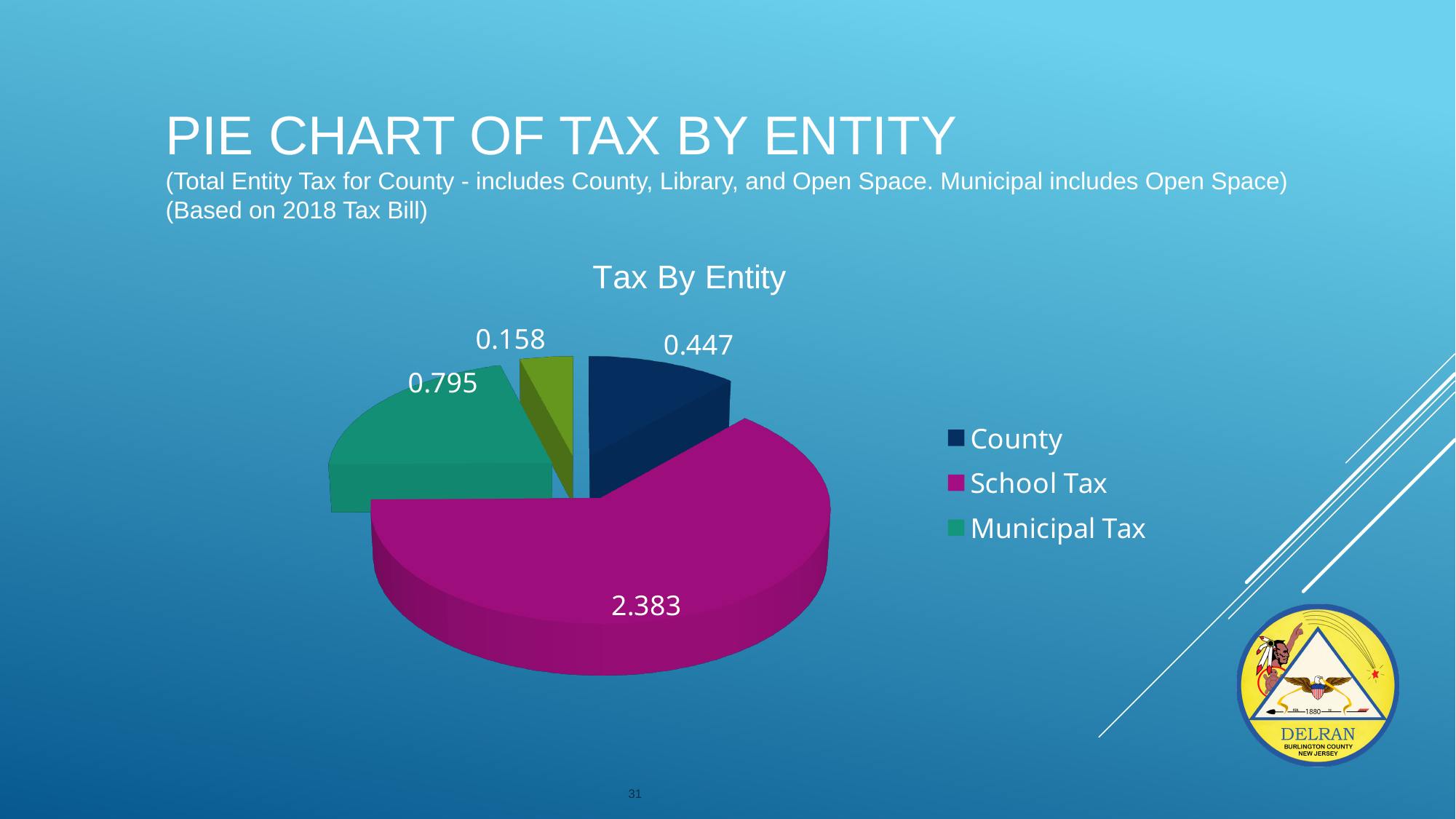
Which entity has the largest slice of the pie? School Tax What is the value for County? 0.447 What is the difference between the Municipal Tax value and the County value? 0.348 What type of chart is shown on the slide? Pie chart What is the value for Municipal Tax? 0.795 What is the value for School Tax? 2.383 Which is larger, the Municipal Tax value or the County value? Municipal Tax How many slices does the pie chart have? 4 What is the smallest value labelled on the pie chart? 0.158 How many entries does the legend list? 3 What is the difference between the School Tax value and the County value? 1.936 What is the title of the chart? Tax By Entity